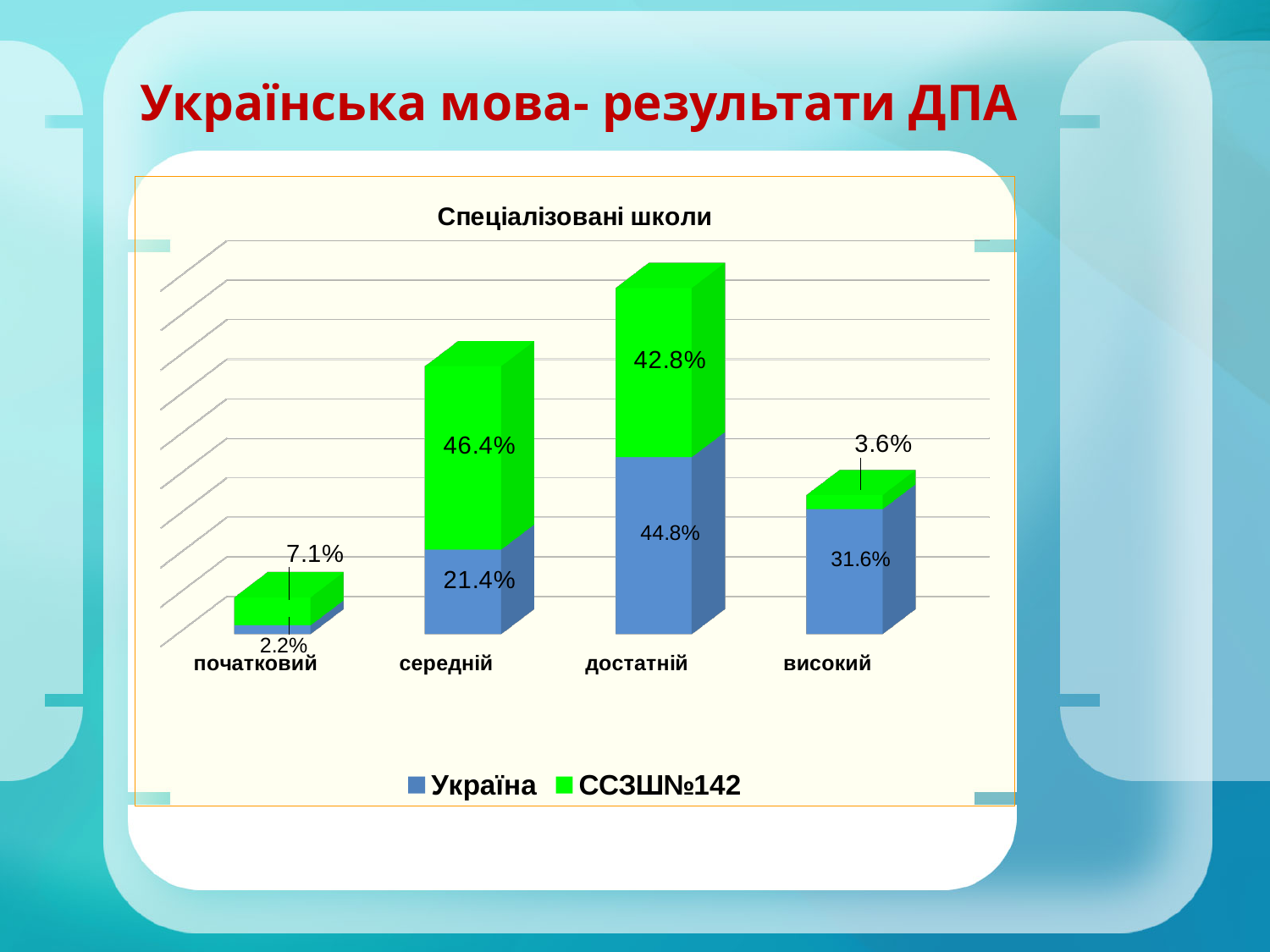
What kind of chart is shown? stacked bar chart What is the difference between the ССЗШ№142 and Україна values in the середній category? 25.0% What is the value for ССЗШ№142 in the середній category? 46.4% In which category is the Україна value lowest? початковий How many categories are shown on the x axis? 4 In which category is the ССЗШ№142 value highest? середній How many series does the legend list? 2 Which is larger in the високий category: the Україна value or the ССЗШ№142 value? Україна What is the value for ССЗШ№142 in the високий category? 3.6% What is the value for Україна in the достатній category? 44.8% What is the value for Україна in the початковий category? 2.2% What is the total of the stacked bar for the достатній category? 87.6%